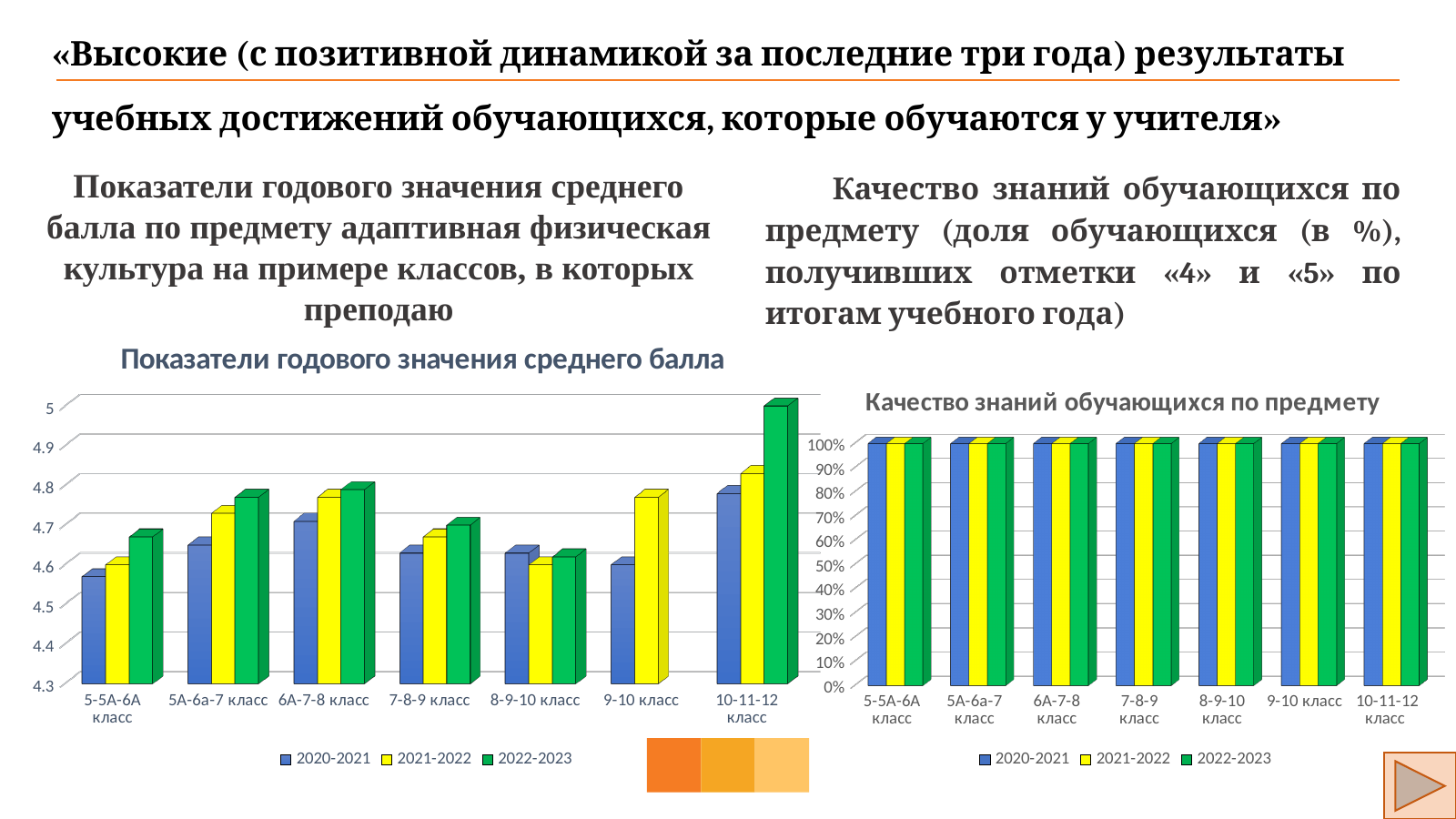
In the left chart "Показатели годового значения среднего балла", is the 2022-2023 value for 10-11-12 класс greater or less than 4.9? greater What type of chart is the left chart titled "Показатели годового значения среднего балла"? bar chart In the left chart "Показатели годового значения среднего балла", which is larger for 5A-6a-7 класс: the 2020-2021 value or the 2022-2023 value? 2022-2023 In the right chart "Качество знаний обучающихся по предмету", which colour represents the 2021-2022 series? yellow How many class categories are shown on the x axis of the left chart "Показатели годового значения среднего балла"? 7 In the right chart "Качество знаний обучающихся по предмету", what is the value for 7-8-9 класс in 2022-2023? 100% In the left chart "Показатели годового значения среднего балла", do the values for 6A-7-8 класс rise or fall from 2020-2021 to 2022-2023? rise In the left chart "Показатели годового значения среднего балла", is the 2020-2021 value for 5-5A-6A класс greater or less than 4.6? less How many class categories are shown on the x axis of the right chart "Качество знаний обучающихся по предмету"? 7 In the left chart "Показатели годового значения среднего балла", which class has the highest value for 2022-2023? 10-11-12 класс How many series does the legend of the left chart "Показатели годового значения среднего балла" list? 3 In the left chart "Показатели годового значения среднего балла", is the 2021-2022 value for 9-10 класс greater or less than 4.7? greater